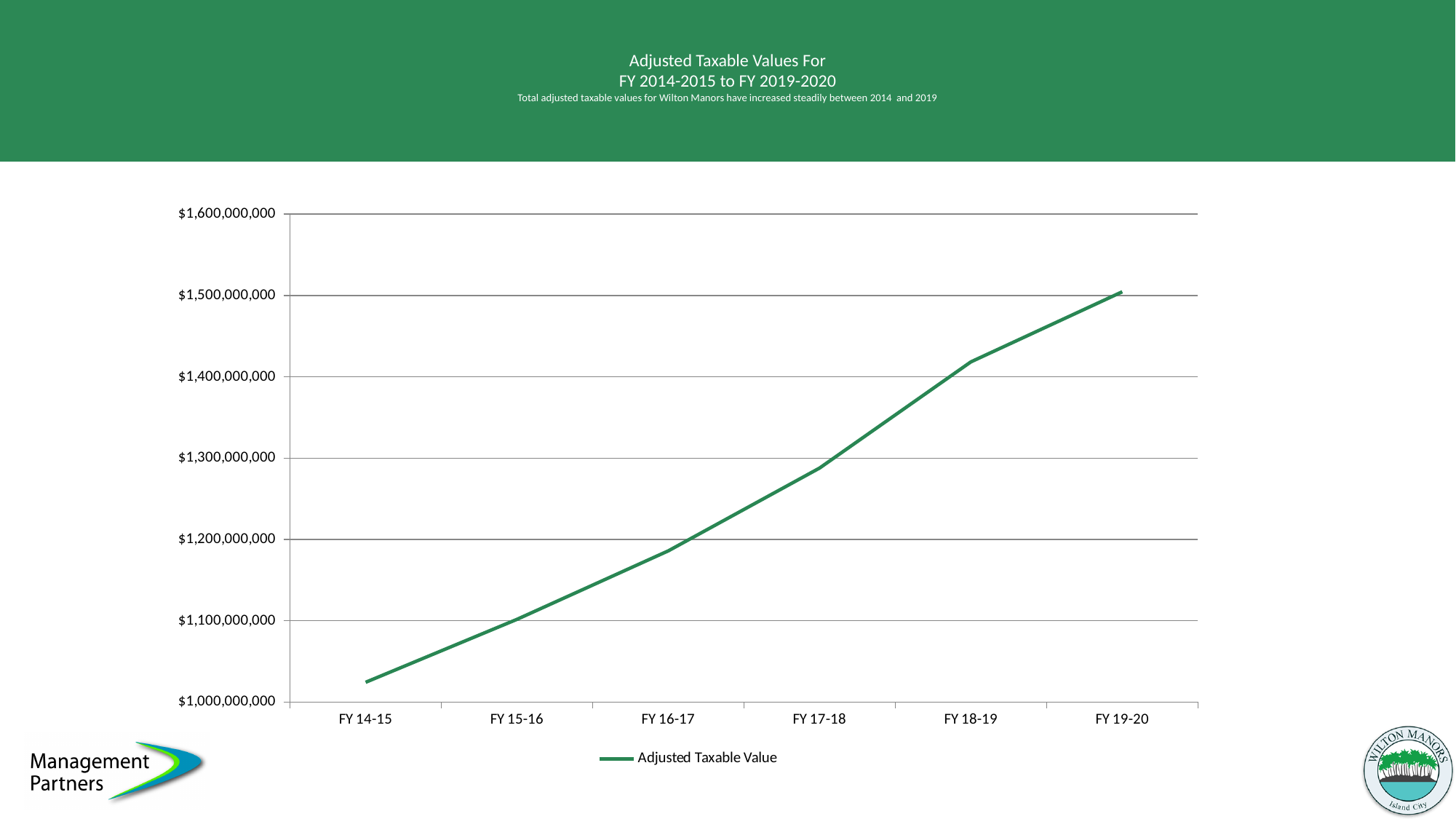
What kind of chart is shown on the slide? line chart How many series does the legend list? 1 How many fiscal years are plotted on the x axis? 6 Is the adjusted taxable value for FY 14-15 greater or less than $1,100,000,000? less Which fiscal year has the lowest adjusted taxable value? FY 14-15 Which fiscal year has the highest adjusted taxable value? FY 19-20 Which is larger, the adjusted taxable value for FY 18-19 or for FY 16-17? FY 18-19 Is the adjusted taxable value for FY 17-18 greater or less than $1,200,000,000? greater What series name is shown in the chart legend? Adjusted Taxable Value Is the adjusted taxable value for FY 16-17 greater or less than $1,300,000,000? less Do the adjusted taxable values rise or fall from FY 14-15 to FY 19-20? rise